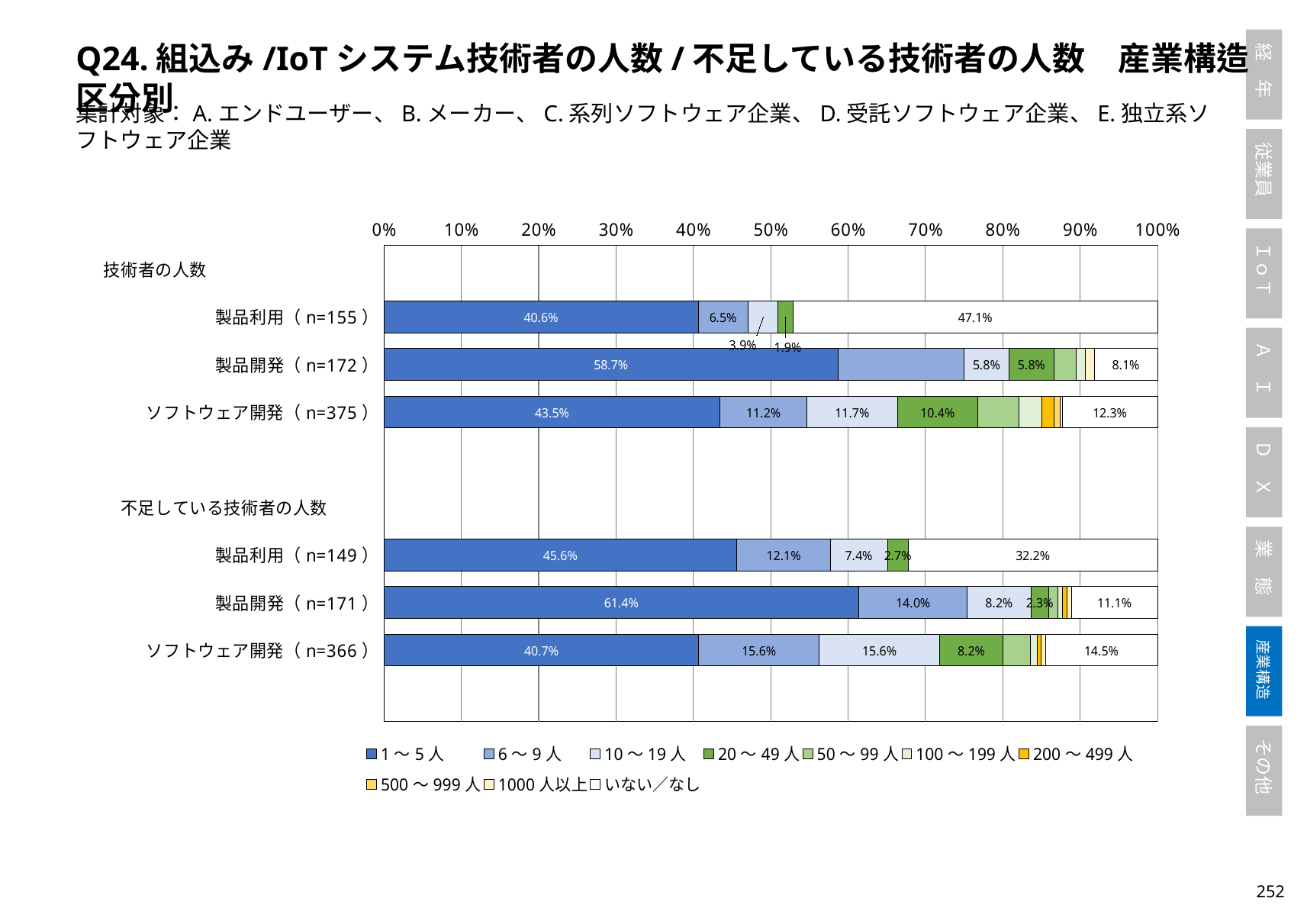
What is the 6～9人 share for 不足している技術者の人数 ソフトウェア開発 (n=366)? 15.6% What kind of chart is shown on the slide? Stacked bar chart What is the いない／なし share for 技術者の人数 製品利用 (n=155)? 47.1% How many series does the legend list? 10 What percentage of 技術者の人数 製品開発 (n=172) respondents fall in the 1～5人 category? 58.7% Which has the larger 20～49人 share: 技術者の人数 ソフトウェア開発 (n=375) or 不足している技術者の人数 ソフトウェア開発 (n=366)? 技術者の人数 ソフトウェア開発 (n=375) Which bar has the largest 1～5人 share? 不足している技術者の人数 製品開発 (n=171) How many bars are plotted in the chart? 6 Which bar has the smallest いない／なし share? 技術者の人数 製品開発 (n=172) What is the difference in the 1～5人 share between 技術者の人数 製品開発 (n=172) and 技術者の人数 製品利用 (n=155)? 18.1 percentage points Is the 6～9人 segment for 技術者の人数 製品開発 (n=172) greater or less than 10%? greater What is the 10～19人 share for 不足している技術者の人数 製品開発 (n=171)? 8.2%